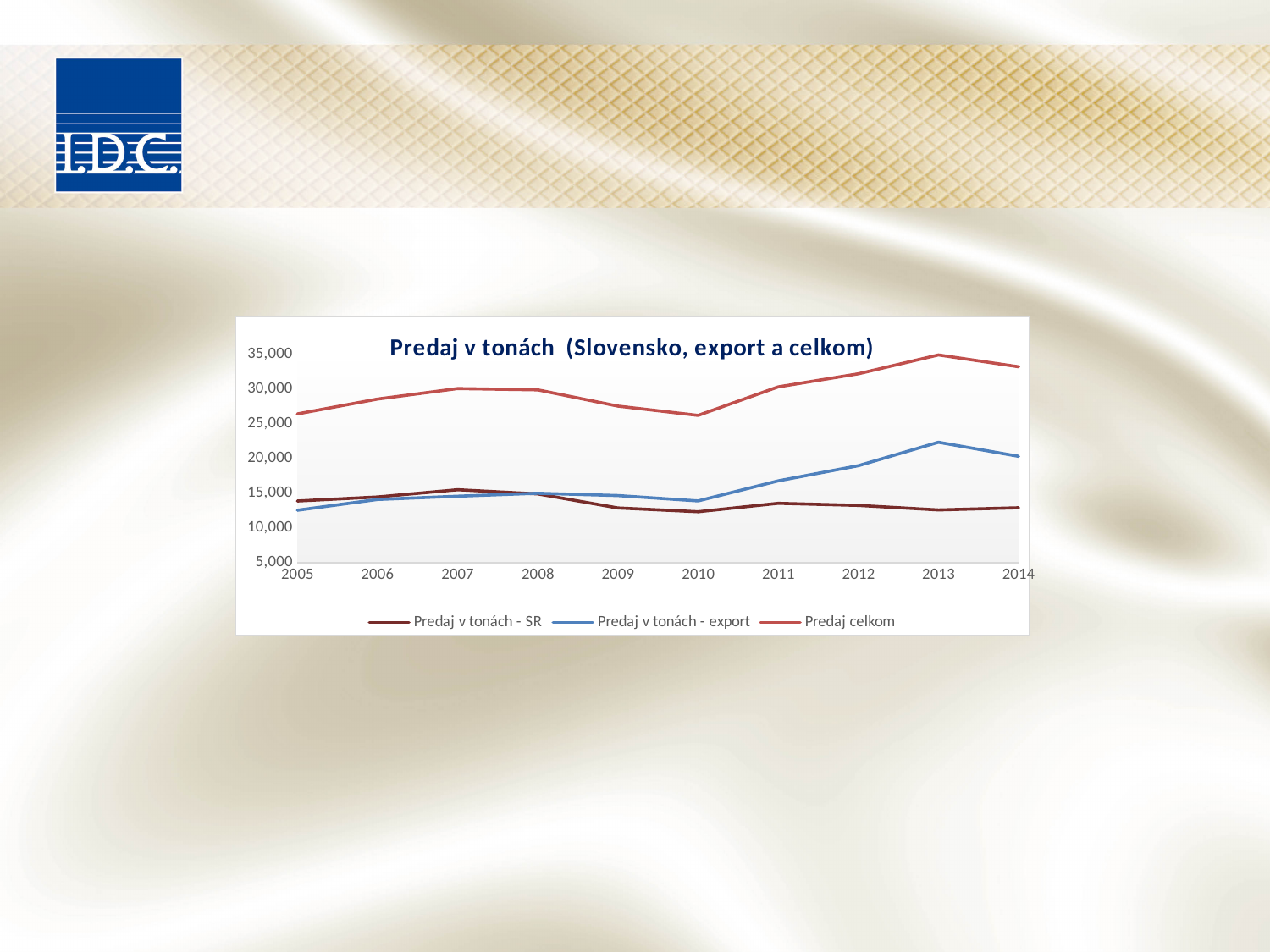
Does the Predaj celkom series rise or fall from 2010 to 2013? rise How many series does the legend list? 3 In which year does the Predaj celkom series reach its lowest value? 2010 What kind of chart is shown on the slide? line chart In 2014, which is larger: Predaj v tonách - export or Predaj v tonách - SR? Predaj v tonách - export Is the value for Predaj celkom in 2010 greater or less than 30,000? less How many years are shown on the x axis? 10 In which year does the Predaj celkom series reach its highest value? 2013 Is the value for Predaj celkom in 2013 greater or less than 30,000? greater What is the title of the chart? Predaj v tonách (Slovensko, export a celkom) In which year does the Predaj v tonách - export series reach its highest value? 2013 Is the value for Predaj v tonách - export in 2013 greater or less than 20,000? greater